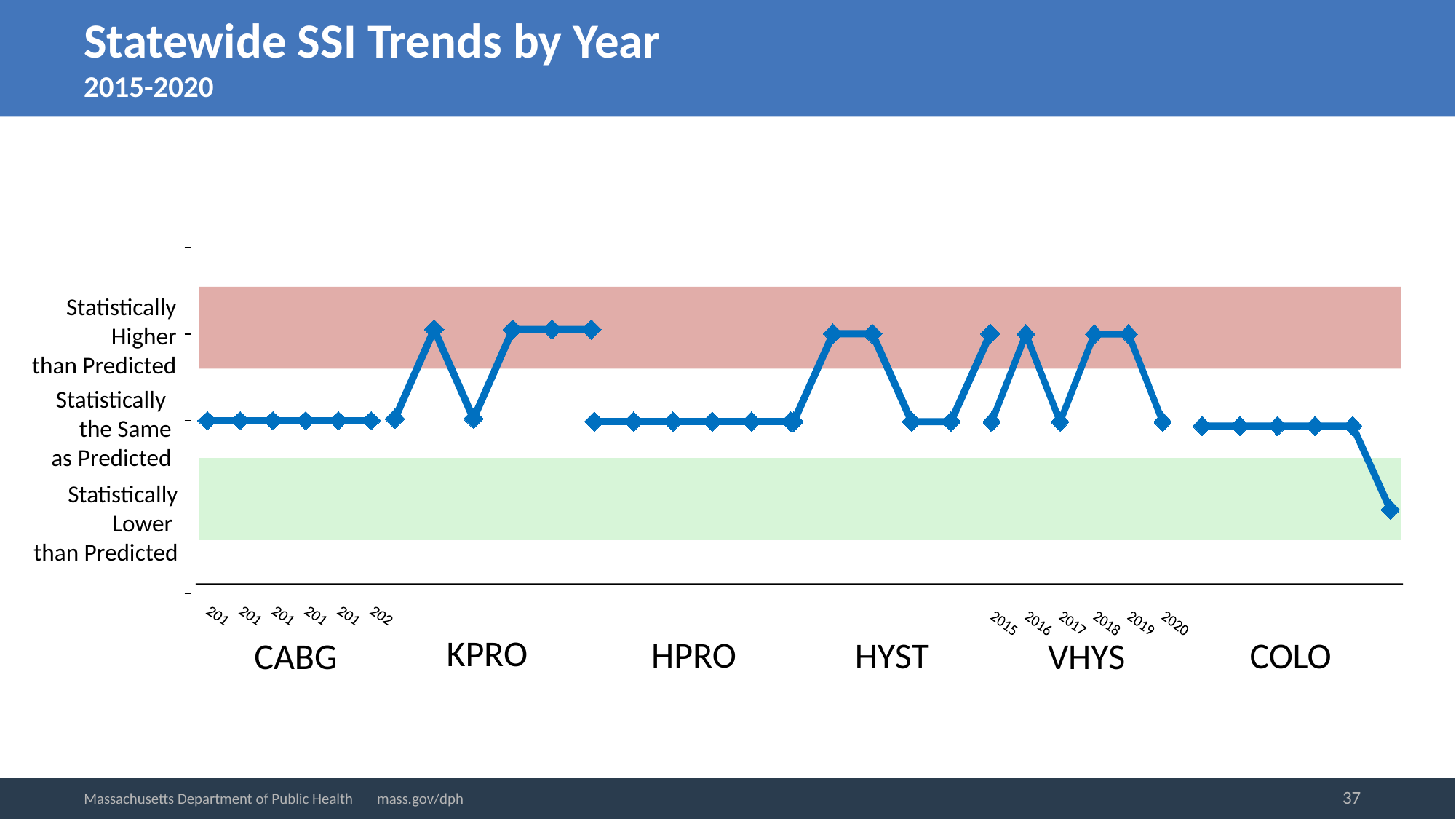
How many KPRO years fall in the Statistically Higher than Predicted band? 4 Which procedure group is the only one with a value in the Statistically Lower than Predicted band? COLO What kind of chart is shown on the slide? line chart Which category do all six CABG values fall into? Statistically the Same as Predicted Which category does the HYST value for 2020 fall into? Statistically Higher than Predicted How many procedure groups are shown along the x axis? 6 Do the COLO values rise or fall from 2019 to 2020? fall Which category does the VHYS value for 2020 fall into? Statistically the Same as Predicted What is the title of the slide? Statewide SSI Trends by Year Which category does the KPRO value for 2016 fall into? Statistically Higher than Predicted How many years are plotted for each procedure group? 6 Which category does the COLO value for 2020 fall into? Statistically Lower than Predicted